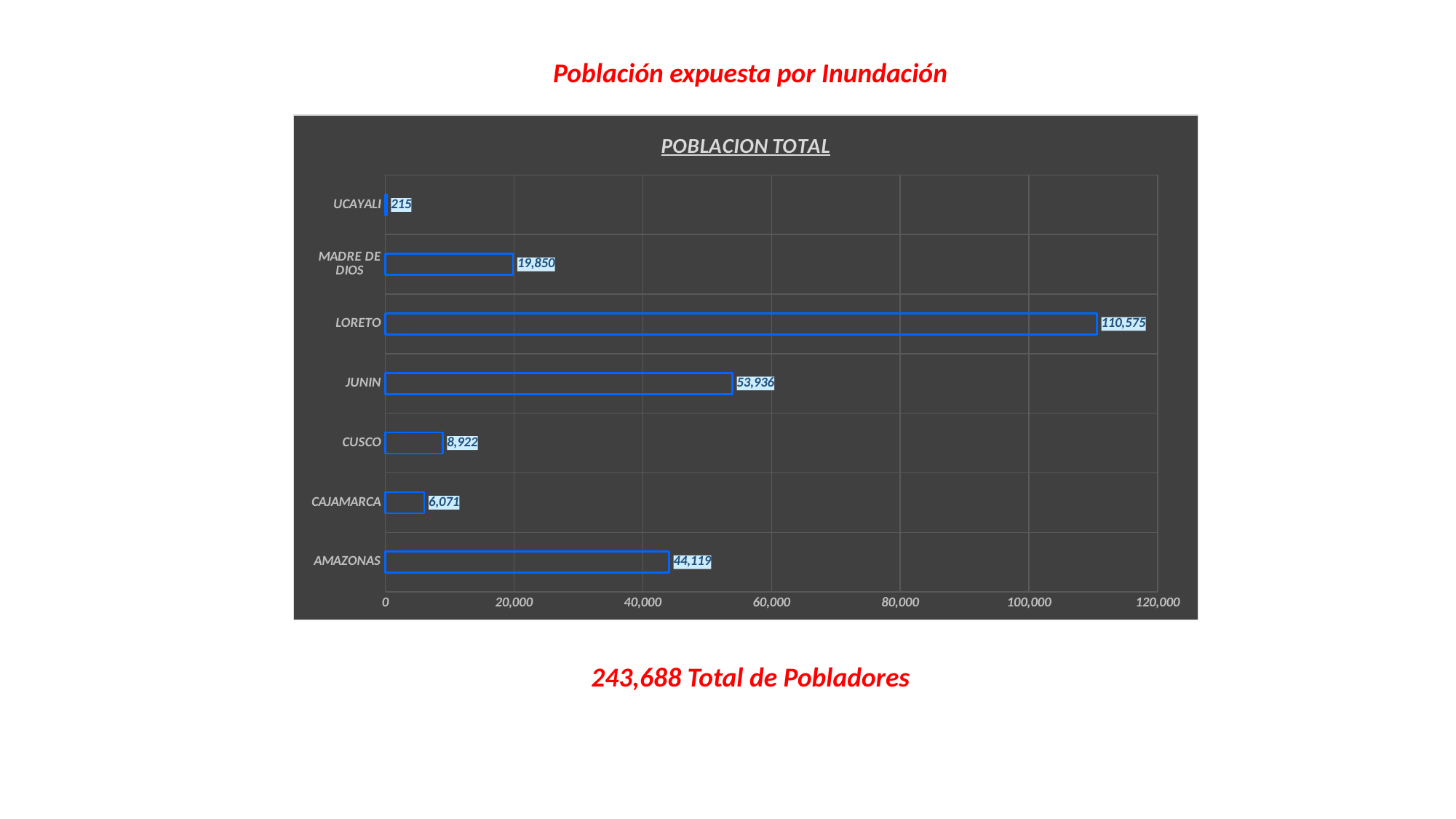
How many categories are shown in the chart? 7 What kind of chart is shown on the slide? bar chart What is the value for LORETO? 110,575 Is the value for JUNIN greater or less than 40,000? greater What is the difference between the values for LORETO and JUNIN? 56,639 Which category has the lowest value? UCAYALI What is the value for MADRE DE DIOS? 19,850 What is the difference between the values for JUNIN and AMAZONAS? 9,817 What is the value for AMAZONAS? 44,119 Which category has the highest value? LORETO What is the title of the chart? POBLACION TOTAL Which is larger, the value for CUSCO or the value for CAJAMARCA? CUSCO